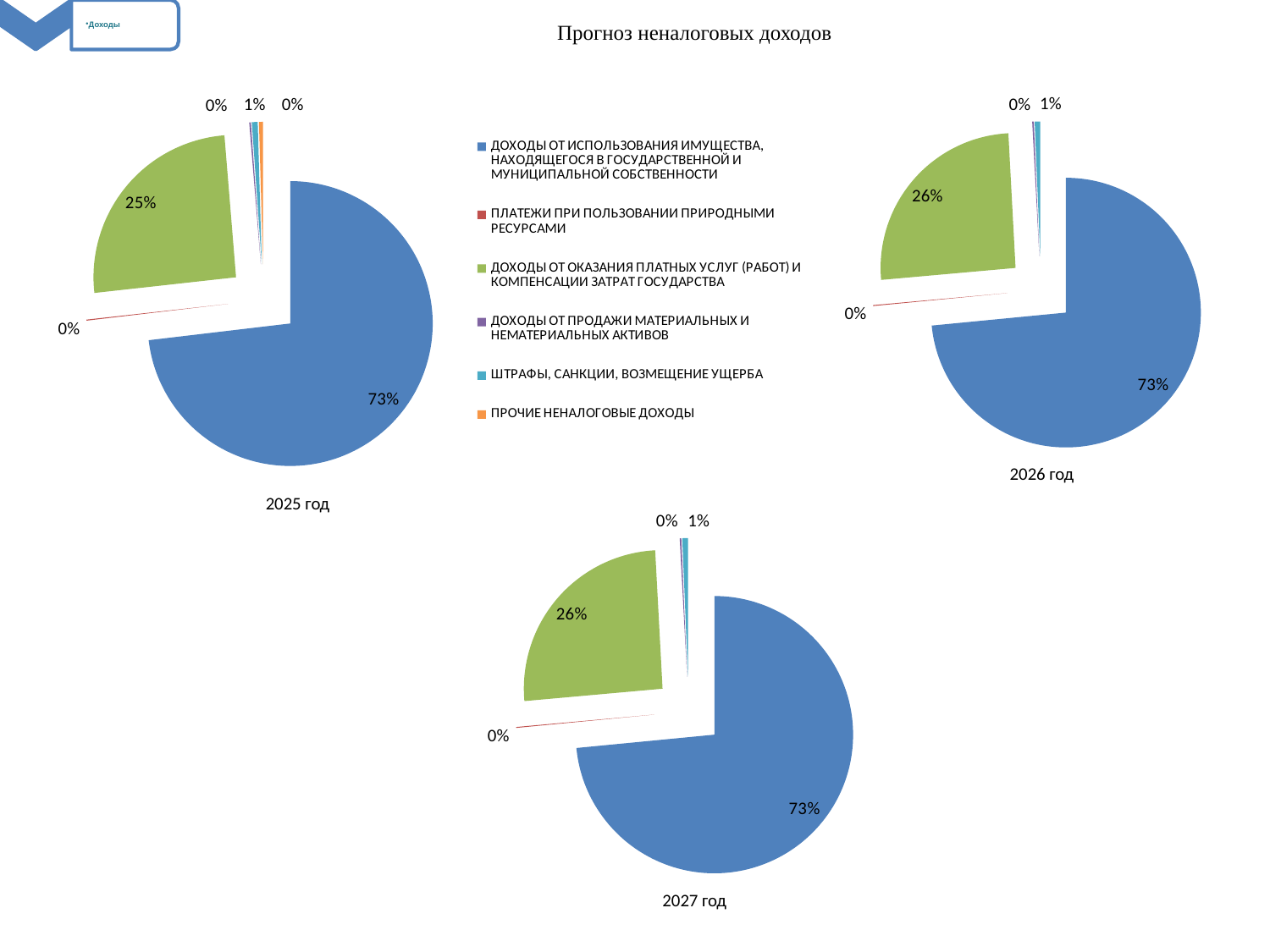
In the 2026 год pie chart, what share is shown for ДОХОДЫ ОТ ОКАЗАНИЯ ПЛАТНЫХ УСЛУГ (РАБОТ) И КОМПЕНСАЦИИ ЗАТРАТ ГОСУДАРСТВА? 26% What is the title of the slide containing the pie charts? Прогноз неналоговых доходов In the 2026 год pie chart, which category has the largest share? ДОХОДЫ ОТ ИСПОЛЬЗОВАНИЯ ИМУЩЕСТВА, НАХОДЯЩЕГОСЯ В ГОСУДАРСТВЕННОЙ И МУНИЦИПАЛЬНОЙ СОБСТВЕННОСТИ In the 2025 год pie chart, what share is shown for ДОХОДЫ ОТ ОКАЗАНИЯ ПЛАТНЫХ УСЛУГ (РАБОТ) И КОМПЕНСАЦИИ ЗАТРАТ ГОСУДАРСТВА? 25% In the 2027 год pie chart, which is larger: the share for ДОХОДЫ ОТ ОКАЗАНИЯ ПЛАТНЫХ УСЛУГ or the share for ШТРАФЫ, САНКЦИИ, ВОЗМЕЩЕНИЕ УЩЕРБА? ДОХОДЫ ОТ ОКАЗАНИЯ ПЛАТНЫХ УСЛУГ (РАБОТ) И КОМПЕНСАЦИИ ЗАТРАТ ГОСУДАРСТВА In the 2027 год pie chart, what share is shown for ДОХОДЫ ОТ ИСПОЛЬЗОВАНИЯ ИМУЩЕСТВА, НАХОДЯЩЕГОСЯ В ГОСУДАРСТВЕННОЙ И МУНИЦИПАЛЬНОЙ СОБСТВЕННОСТИ? 73% In the 2025 год pie chart, what is the difference in percentage points between the share for ДОХОДЫ ОТ ИСПОЛЬЗОВАНИЯ ИМУЩЕСТВА and the share for ДОХОДЫ ОТ ОКАЗАНИЯ ПЛАТНЫХ УСЛУГ? 48 How many pie charts are shown on the slide? 3 How many categories does the shared legend list? 6 What type of chart is used for 2025 год? Pie chart